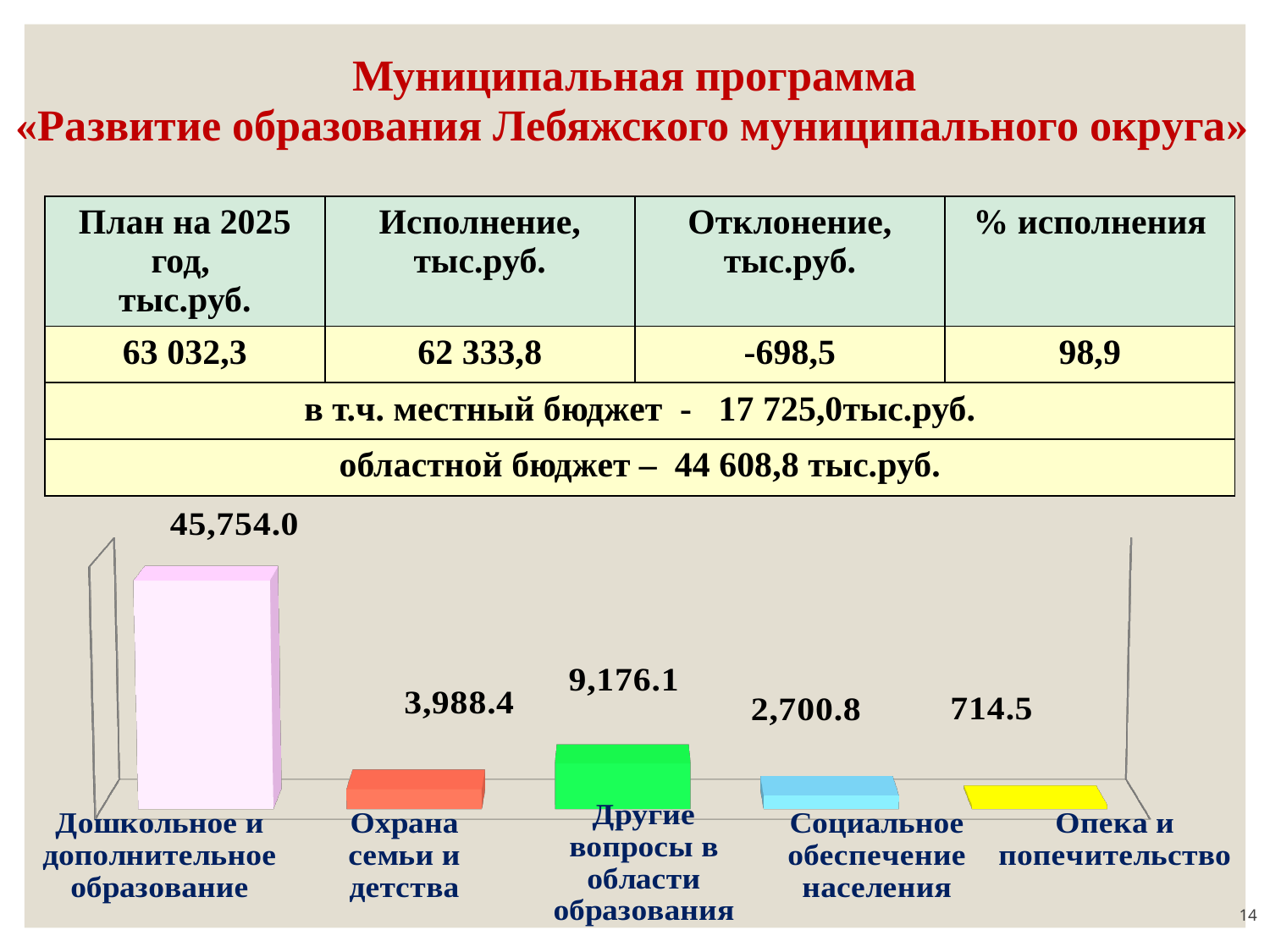
What value is shown for the bar labelled «Опека и попечительство»? 714.5 Which category has the highest value in the bar chart? Дошкольное и дополнительное образование What colour is the bar for «Другие вопросы в области образования»? Green What kind of chart is shown at the bottom of the slide? Bar chart Which is larger: the value for «Другие вопросы в области образования» or the value for «Охрана семьи и детства»? Другие вопросы в области образования What value is shown for the bar labelled «Другие вопросы в области образования»? 9,176.1 How many categories are shown in the bar chart? 5 Which category has the lowest value in the bar chart? Опека и попечительство What value is shown for the bar labelled «Дошкольное и дополнительное образование»? 45,754.0 What value is shown for the bar labelled «Охрана семьи и детства»? 3,988.4 What is the difference between the values for «Дошкольное и дополнительное образование» and «Другие вопросы в области образования»? 36,577.9 What is the difference between the values for «Охрана семьи и детства» and «Социальное обеспечение населения»? 1,287.6